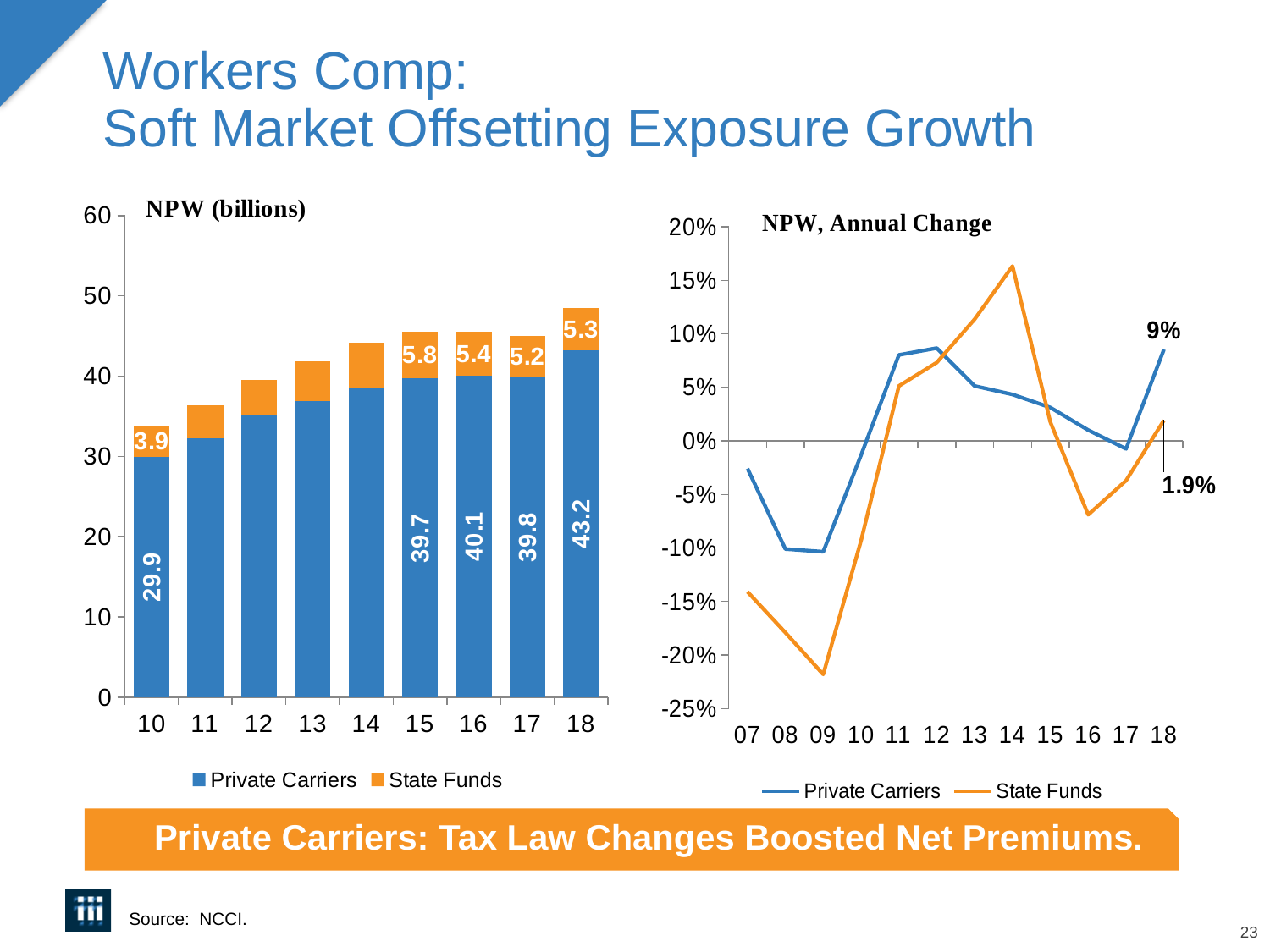
In the 'NPW (billions)' chart, what is the total of the stacked bar for 18? 48.5 What kind of chart is the 'NPW, Annual Change' chart on the right? line chart In the 'NPW (billions)' chart, how many years are shown on the x axis? 9 In the 'NPW, Annual Change' chart, in which year is the State Funds line at its lowest? 09 In the 'NPW (billions)' chart, what is the State Funds value for 15? 5.8 In the 'NPW (billions)' chart, what is the Private Carriers value for 18? 43.2 What kind of chart is the 'NPW (billions)' chart on the left? bar chart In the 'NPW (billions)' chart, how many series does the legend list? 2 In the 'NPW, Annual Change' chart, what is the State Funds value for 18? 1.9% In the 'NPW, Annual Change' chart, is the Private Carriers value for 09 greater or less than -5%? less In the 'NPW, Annual Change' chart, what is the Private Carriers value for 18? 9% In the 'NPW (billions)' chart, what is the difference between the Private Carriers values for 18 and 17? 3.4